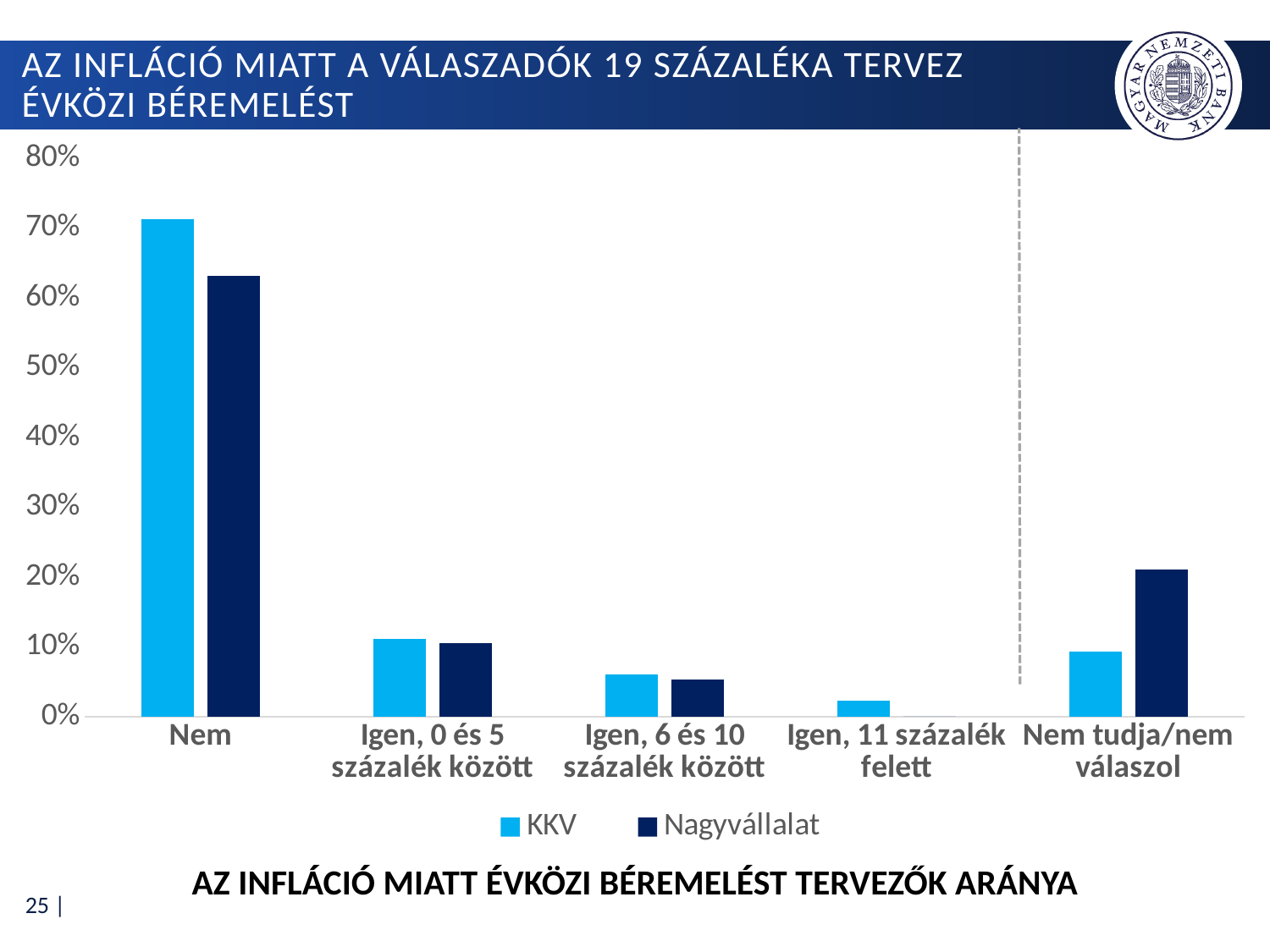
For Nem tudja/nem válaszol, which series has the larger value, KKV or Nagyvállalat? Nagyvállalat Is the KKV value for Nem greater or less than 70%? greater How many series does the legend list? 2 Is the Nagyvállalat value for Nem greater or less than 70%? less Is the Nagyvállalat value for Nem tudja/nem válaszol greater or less than 20%? greater How many categories are shown on the x axis? 5 Which category has the highest value for KKV? Nem What are the two series named in the legend? KKV and Nagyvállalat Which category has the lowest value for KKV? Igen, 11 százalék felett Which category has the highest value for Nagyvállalat? Nem What kind of chart is shown on the slide? bar chart For Nem, which series has the larger value, KKV or Nagyvállalat? KKV